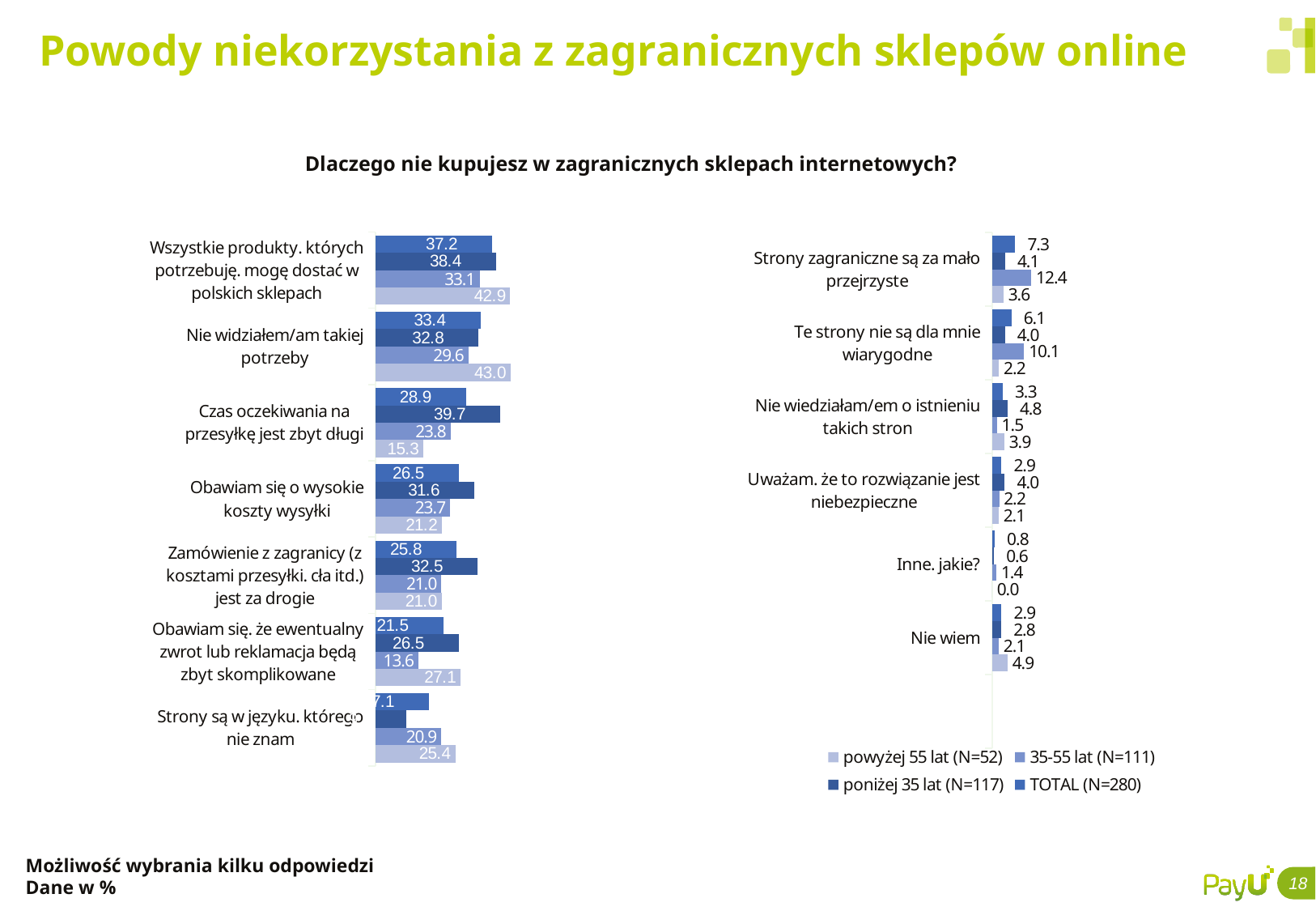
What type of chart is used on this slide? Bar chart In the left chart, what is the difference between the powyżej 55 lat (N=52) and 35-55 lat (N=111) values for "Obawiam się, że ewentualny zwrot lub reklamacja będą zbyt skomplikowane"? 13.5 In the right chart, what is the powyżej 55 lat (N=52) value for "Nie wiem"? 4.9 In the right chart, which category has the lowest TOTAL (N=280) value? Inne, jakie? In the left chart, which category has the highest TOTAL (N=280) value? Wszystkie produkty, których potrzebuję, mogę dostać w polskich sklepach How many series does the legend list? 4 What question is shown as the title above the charts? Dlaczego nie kupujesz w zagranicznych sklepach internetowych? In the right chart, which is larger for "Te strony nie są dla mnie wiarygodne": the 35-55 lat (N=111) value or the poniżej 35 lat (N=117) value? 35-55 lat (N=111) In the right chart, what is the 35-55 lat (N=111) value for "Strony zagraniczne są za mało przejrzyste"? 12.4 How many categories are shown in the right chart? 6 In the left chart, what is the value for "Czas oczekiwania na przesyłkę jest zbyt długi" among poniżej 35 lat (N=117)? 39.7 In the left chart, what is the TOTAL (N=280) value for "Nie widziałem/am takiej potrzeby"? 33.4